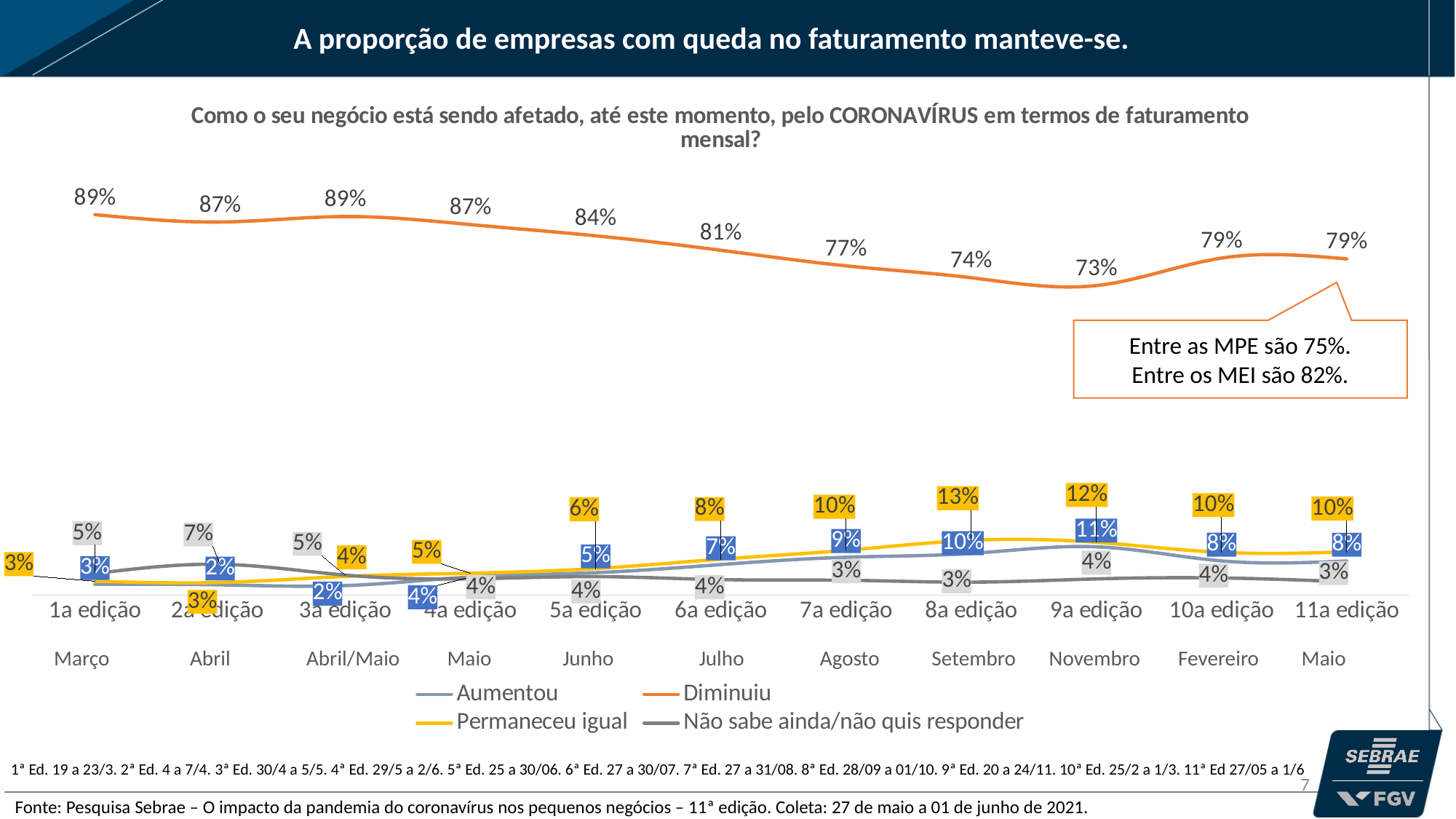
At which edition is the Permaneceu igual series highest? 8a edição What is the value of the Diminuiu series at the 1a edição? 89% What is the value of the Diminuiu series at the 11a edição? 79% At which edition is the Diminuiu series lowest? 9a edição What is the difference between the Diminuiu value at the 1a edição and at the 9a edição? 16 percentage points What is the value of the Permaneceu igual series at the 8a edição? 13% What is the value of the Aumentou series at the 9a edição? 11% How many series does the legend list? 4 Does the Diminuiu series generally rise or fall from the 1a edição to the 9a edição? Fall How many editions (data points) are plotted along the x axis? 11 Which is larger at the 6a edição: Aumentou or Permaneceu igual? Permaneceu igual What type of chart is shown on the slide? Line chart